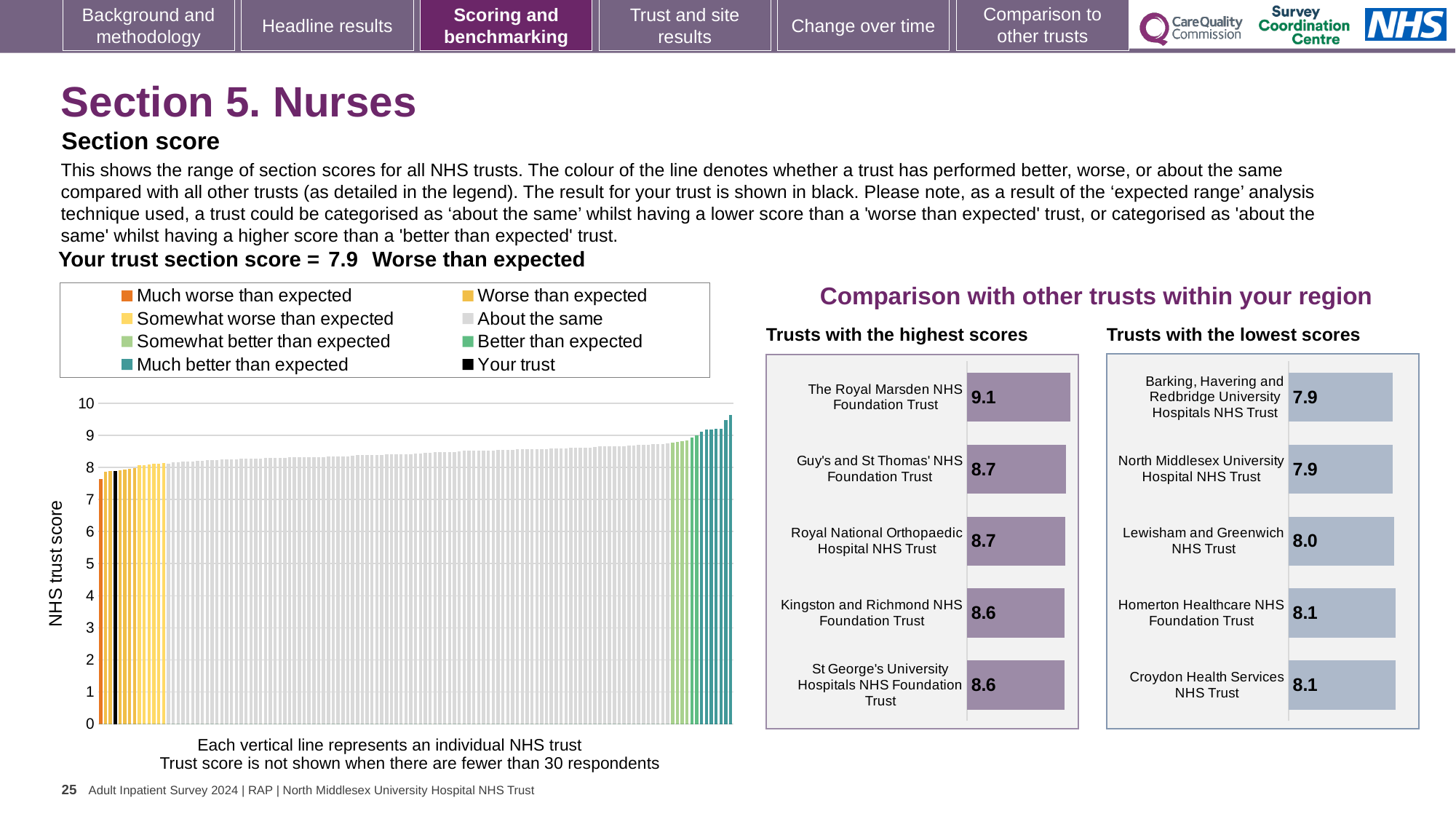
In the 'Trusts with the lowest scores' chart, what is the score for Croydon Health Services NHS Trust? 8.1 In the 'Trusts with the lowest scores' chart, how many trusts are shown? 5 In the NHS trust score chart on the left, is the value for your trust (the black bar) greater or less than 9? less In the 'Trusts with the lowest scores' chart, which has the larger score: Lewisham and Greenwich NHS Trust or North Middlesex University Hospital NHS Trust? Lewisham and Greenwich NHS Trust In the 'Trusts with the highest scores' chart, what is the score for The Royal Marsden NHS Foundation Trust? 9.1 What kind of chart is the NHS trust score chart on the left of the slide? Bar chart In the 'Trusts with the lowest scores' chart, what is the score for Lewisham and Greenwich NHS Trust? 8.0 How many entries does the legend of the NHS trust score chart on the left list? 8 In the 'Trusts with the highest scores' chart, what is the score for Kingston and Richmond NHS Foundation Trust? 8.6 In the NHS trust score chart on the left, do the values rise or fall from left to right along the x axis? Rise In the 'Trusts with the highest scores' chart, which trust has the highest score? The Royal Marsden NHS Foundation Trust In the 'Trusts with the highest scores' chart, what is the difference between the scores of The Royal Marsden NHS Foundation Trust and Guy's and St Thomas' NHS Foundation Trust? 0.4